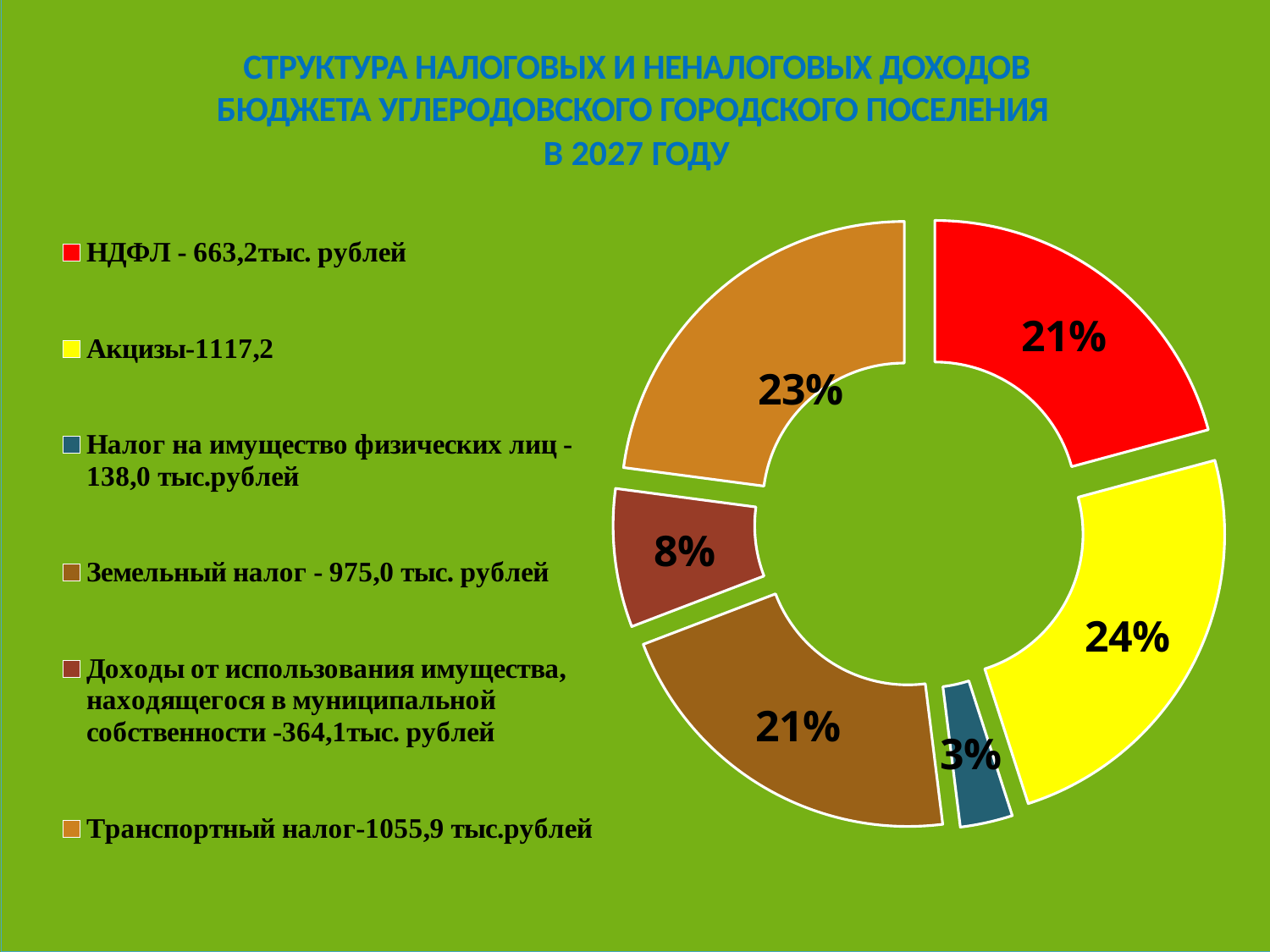
How many categories are shown in the chart? 6 What share of the chart does Акцизы represent? 24% What kind of chart is shown on the slide? Doughnut chart What value is given in the legend for Земельный налог? 975,0 тыс. рублей Which category has the largest share of the chart? Акцизы Which has a larger share, Транспортный налог or Земельный налог? Транспортный налог What share of the chart does Доходы от использования имущества, находящегося в муниципальной собственности represent? 8% What is the difference in percentage points between the shares of Акцизы and Доходы от использования имущества, находящегося в муниципальной собственности? 16 Which category has the smallest share of the chart? Налог на имущество физических лиц What share of the chart does НДФЛ represent? 21%